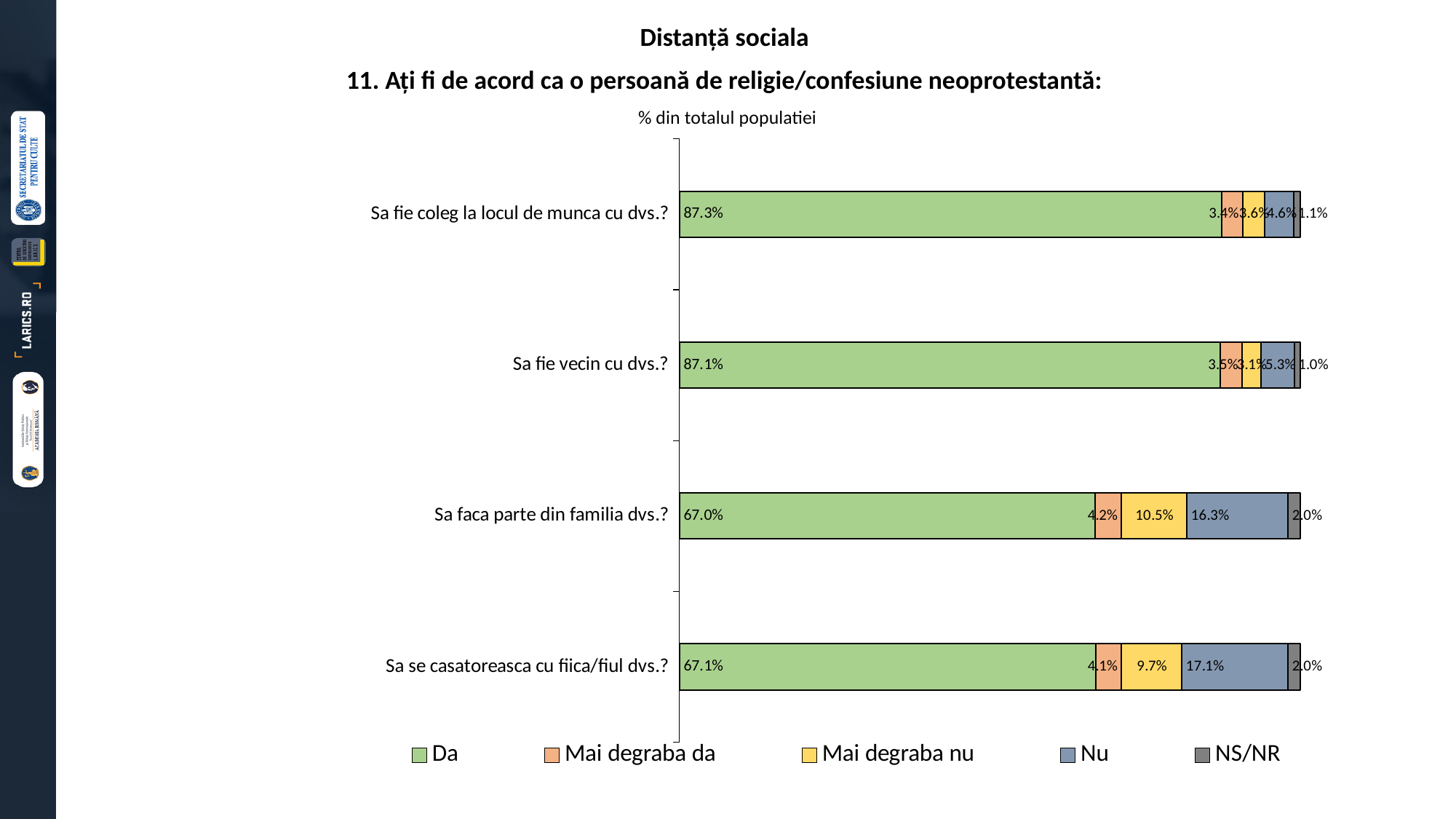
How many series does the legend list? 5 How many categories (questions) are shown on the chart? 4 What is the "NS/NR" value for "Sa faca parte din familia dvs.?"? 2.0% What percentage answered "Da" for "Sa fie coleg la locul de munca cu dvs.?"? 87.3% What is the difference in percentage points between the "Da" value for "Sa fie coleg la locul de munca cu dvs.?" and for "Sa faca parte din familia dvs.?"? 20.3 percentage points Which category has the highest "Mai degraba nu" value? Sa faca parte din familia dvs.? What is the "Mai degraba nu" value for "Sa faca parte din familia dvs.?"? 10.5% What kind of chart is shown on the slide? Stacked bar chart What percentage answered "Nu" for "Sa se casatoreasca cu fiica/fiul dvs.?"? 17.1% Which has a larger "Da" value: "Sa fie vecin cu dvs.?" or "Sa faca parte din familia dvs.?"? Sa fie vecin cu dvs.? What are the legend entries of the chart? Da, Mai degraba da, Mai degraba nu, Nu, NS/NR What percentage answered "Da" for "Sa faca parte din familia dvs.?"? 67.0%